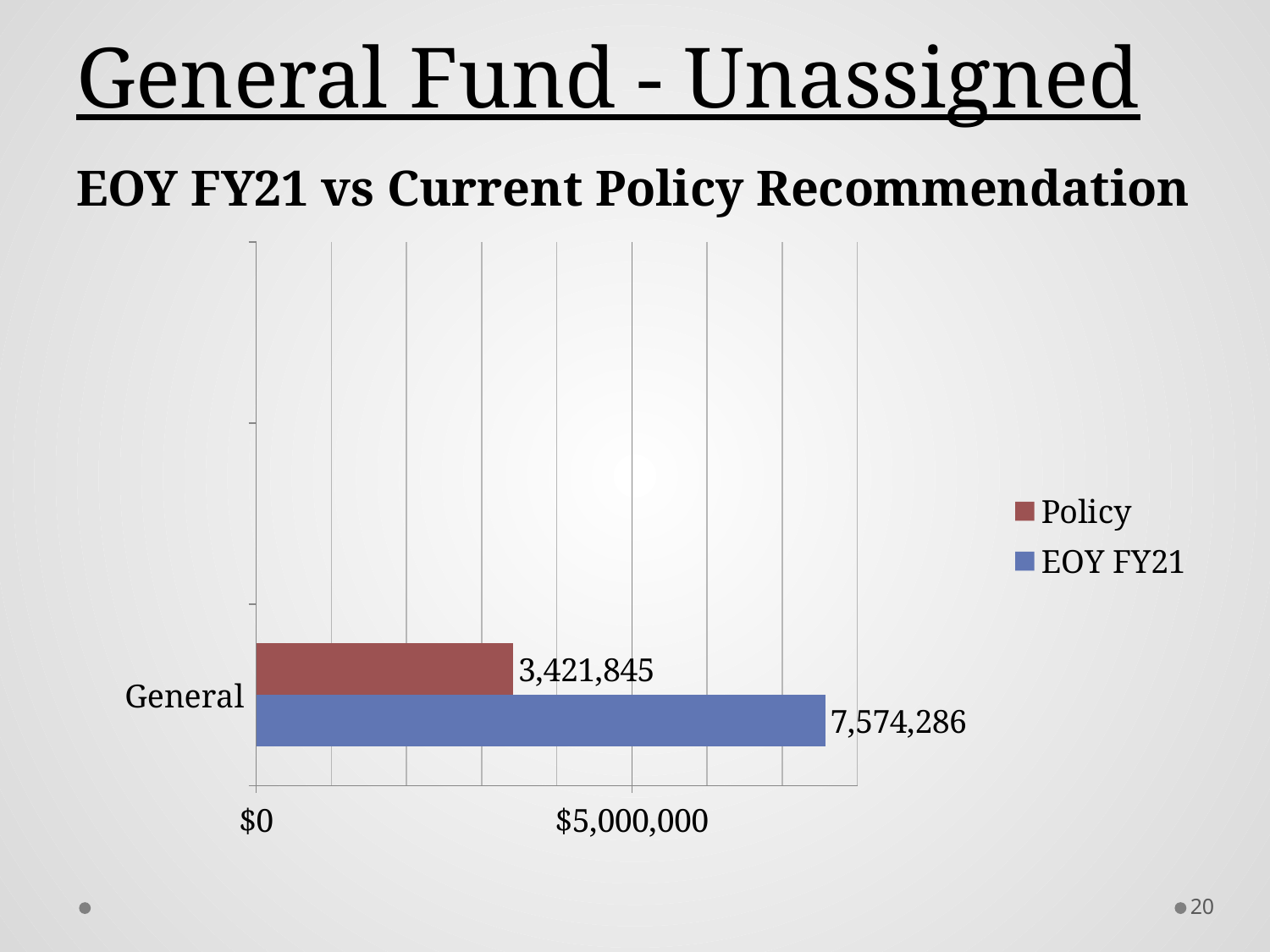
How many categories are shown on the chart? 1 Is the EOY FY21 value for General greater or less than $5,000,000? greater What kind of chart is shown on the slide? bar chart Is the Policy value for General greater or less than $5,000,000? less What is the difference between the EOY FY21 value and the Policy value for General? 4,152,441 How many series does the legend list? 2 Which series is shown in blue in the legend? EOY FY21 Which series has the larger value for General, Policy or EOY FY21? EOY FY21 What is the Policy value for General? 3,421,845 What is the title of the chart? EOY FY21 vs Current Policy Recommendation What is the EOY FY21 value for General? 7,574,286